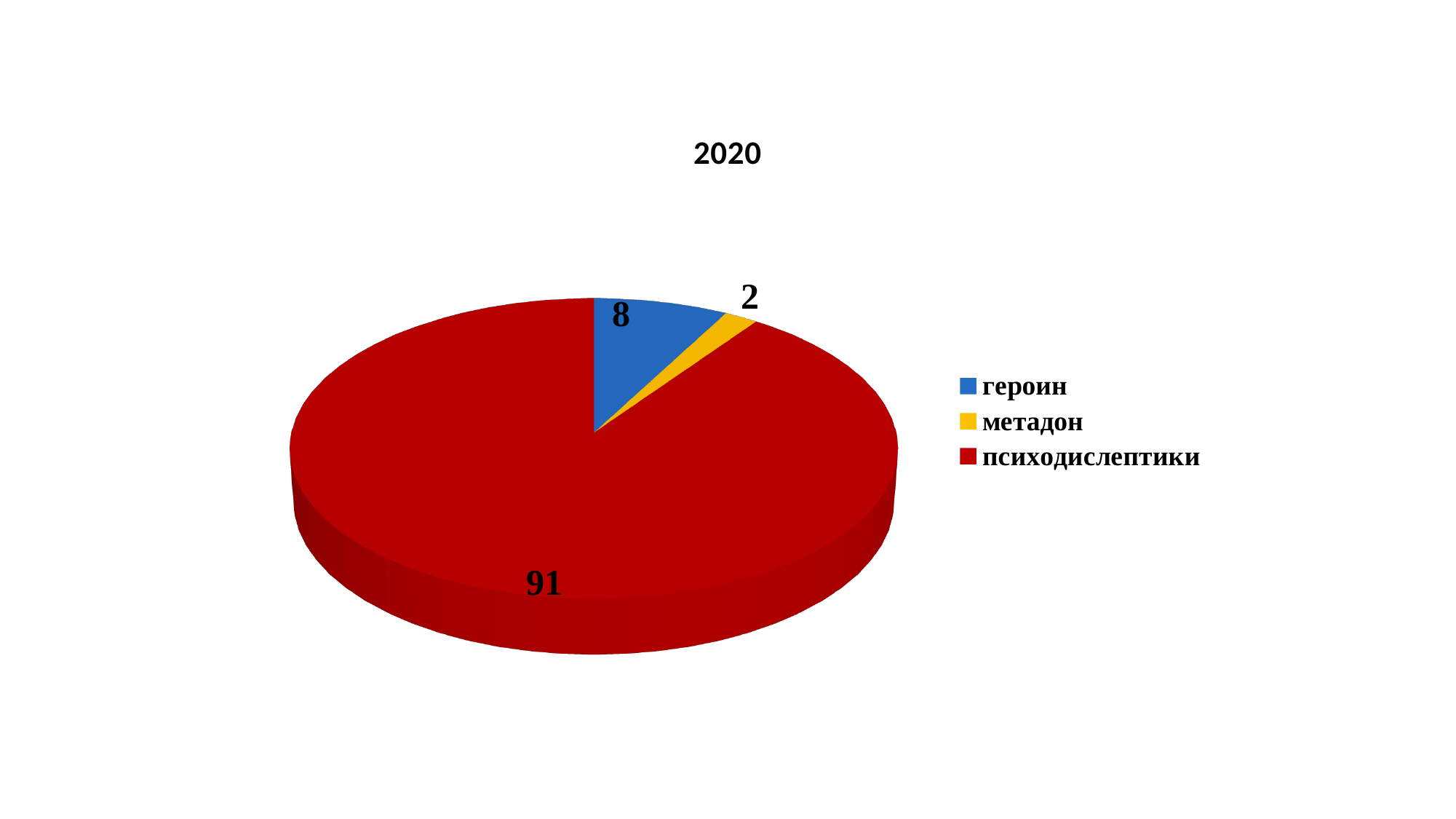
Which category has the smallest slice in the pie chart? метадон What colour is the slice for метадон? yellow What is the value for психодислептики in the pie chart? 91 Which is larger, the value for героин or the value for метадон? героин What is the difference between the values for психодислептики and героин? 83 Which category has the largest slice in the pie chart? психодислептики What is the difference between the values for героин and метадон? 6 What is the value for метадон in the pie chart? 2 What kind of chart is shown on the slide? pie chart How many categories are shown in the pie chart? 3 What is the title of the chart? 2020 What is the value for героин in the pie chart? 8